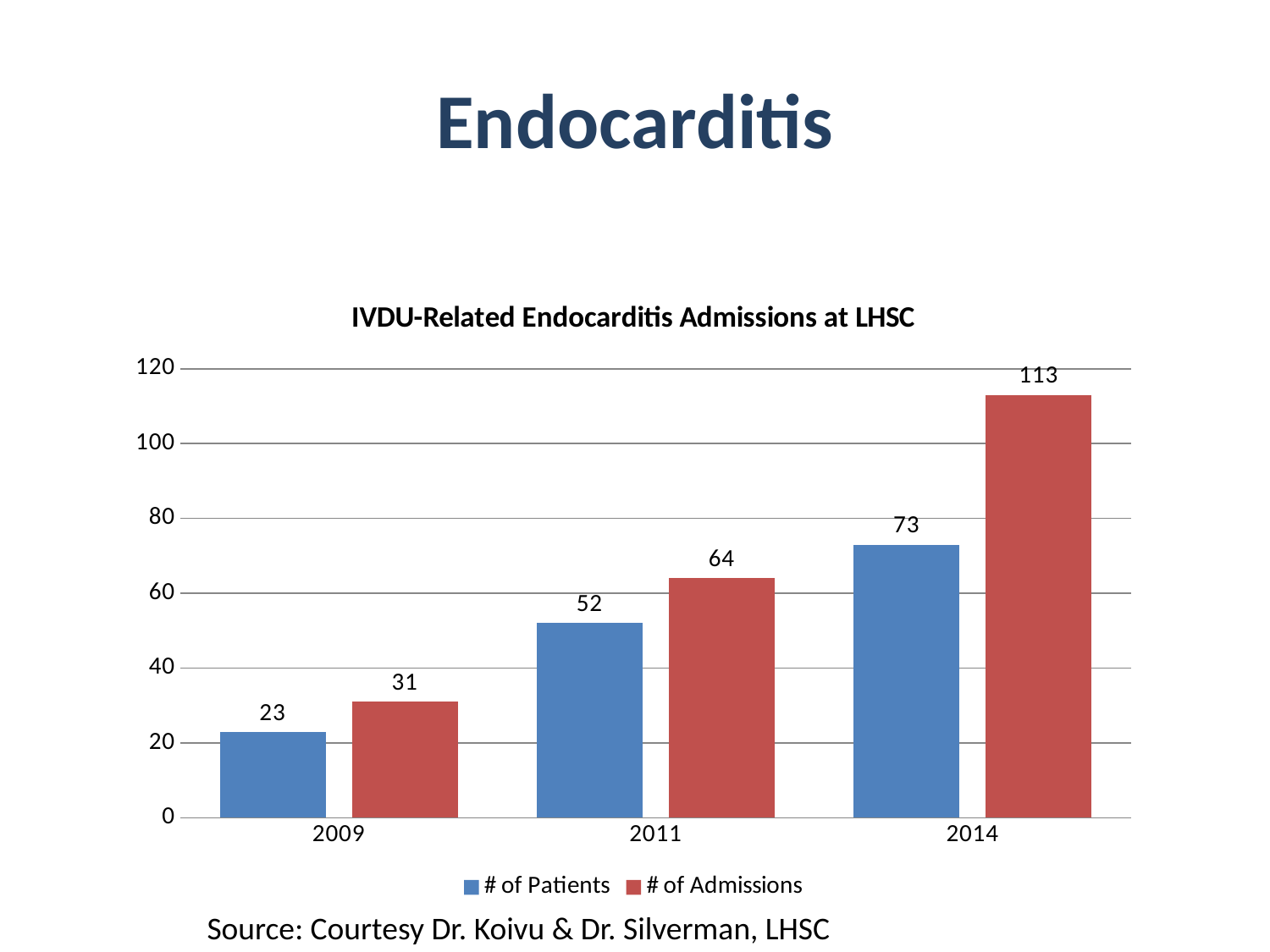
What is the number of admissions in 2011? 64 What is the difference between the number of admissions and the number of patients in 2014? 40 What is the number of patients in 2009? 23 Which is larger in 2011: the number of patients or the number of admissions? # of Admissions How many years are shown on the x axis? 3 How many series does the legend list? 2 What is the number of admissions in 2014? 113 What is the difference in the number of patients between 2011 and 2009? 29 Which year has the highest number of patients? 2014 Do the number of admissions rise or fall from 2009 to 2014? Rise What kind of chart is shown on the slide? Bar chart Which year has the lowest number of admissions? 2009